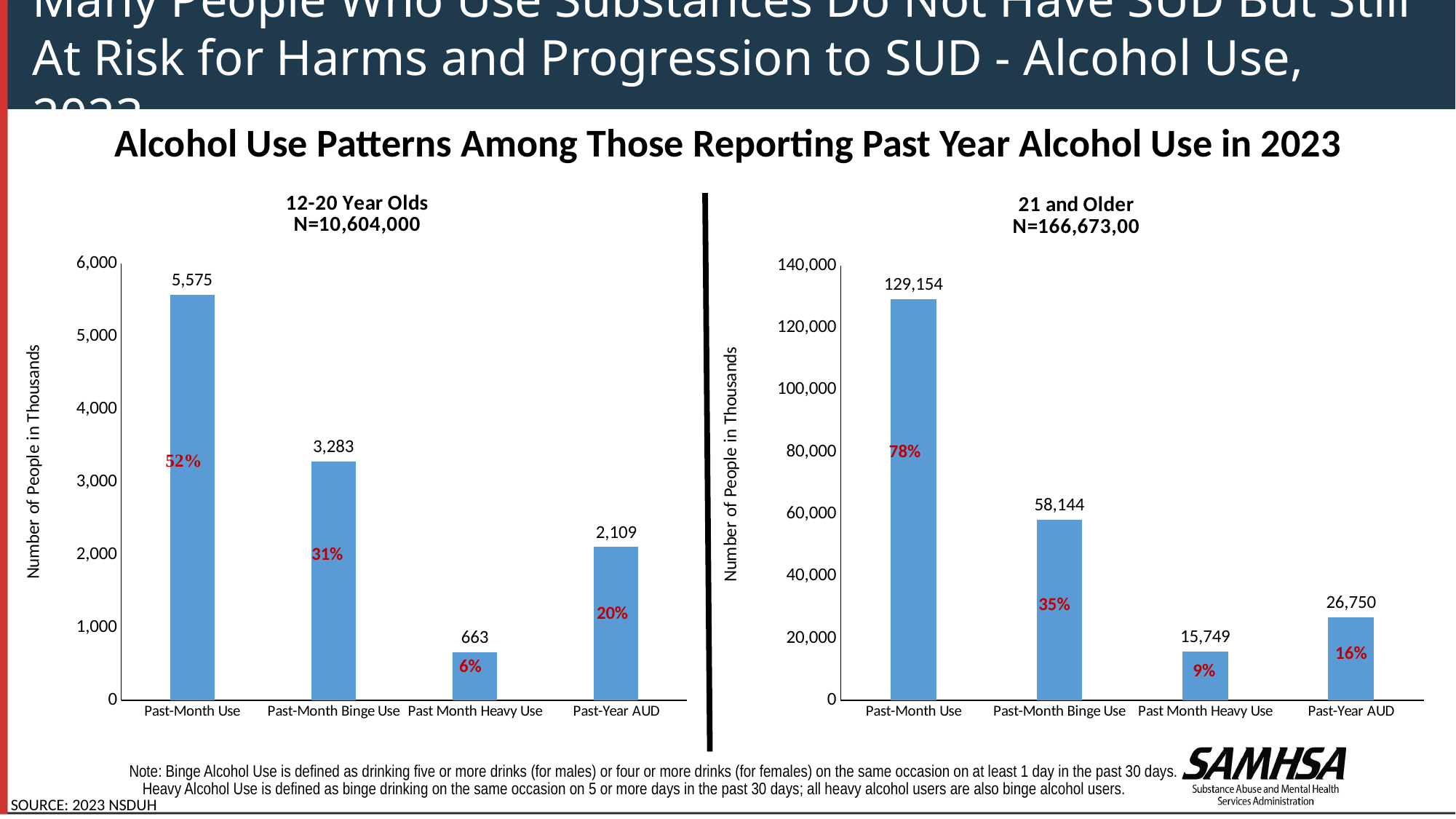
In the 21 and Older chart, is the value for Past-Year AUD greater or less than 20,000? greater In the 12-20 Year Olds chart, what is the difference between Past-Year AUD and Past Month Heavy Use? 1,446 What type of chart is used for the 21 and Older data? Bar chart In the 21 and Older chart, what is the value for Past-Month Binge Use? 58,144 In the 12-20 Year Olds chart, which category has the highest value? Past-Month Use How many categories are shown in the 12-20 Year Olds chart? 4 In the 21 and Older chart, what is the difference between Past-Month Use and Past-Month Binge Use? 71,010 In the 21 and Older chart, which category has the lowest value? Past Month Heavy Use In the 12-20 Year Olds chart, what is the value for Past-Month Use? 5,575 In the 12-20 Year Olds chart, what percentage is shown on the Past-Year AUD bar? 20% What is the y-axis label of the 12-20 Year Olds chart? Number of People in Thousands In the 12-20 Year Olds chart, which is larger, Past-Month Binge Use or Past-Year AUD? Past-Month Binge Use